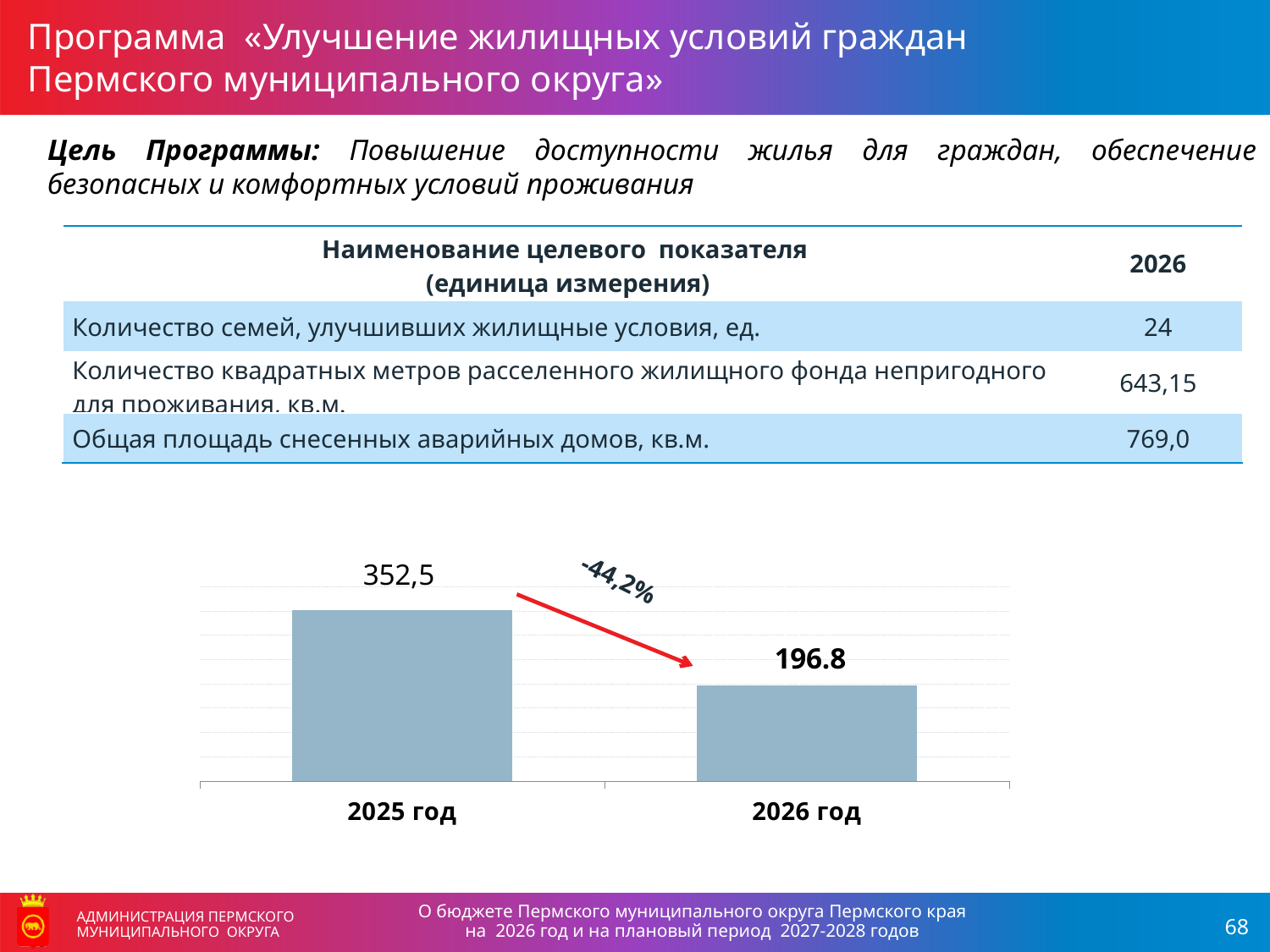
Which is larger in the chart: the value for 2025 год or the value for 2026 год? 2025 год Do the values in the chart rise or fall from 2025 год to 2026 год? Fall What type of chart is shown on the slide? Bar chart What is the value shown for 2025 год in the bar chart? 352,5 What is the value shown for 2026 год in the bar chart? 196.8 Which year has the lowest bar in the chart? 2026 год What percentage change is written next to the arrow between the two bars in the chart? -44,2% What colour is the arrow drawn between the two bars in the chart? Red By how much does the value for 2025 год exceed the value for 2026 год in the chart? 155,7 Which year has the highest bar in the chart? 2025 год How many bars are plotted in the chart? 2